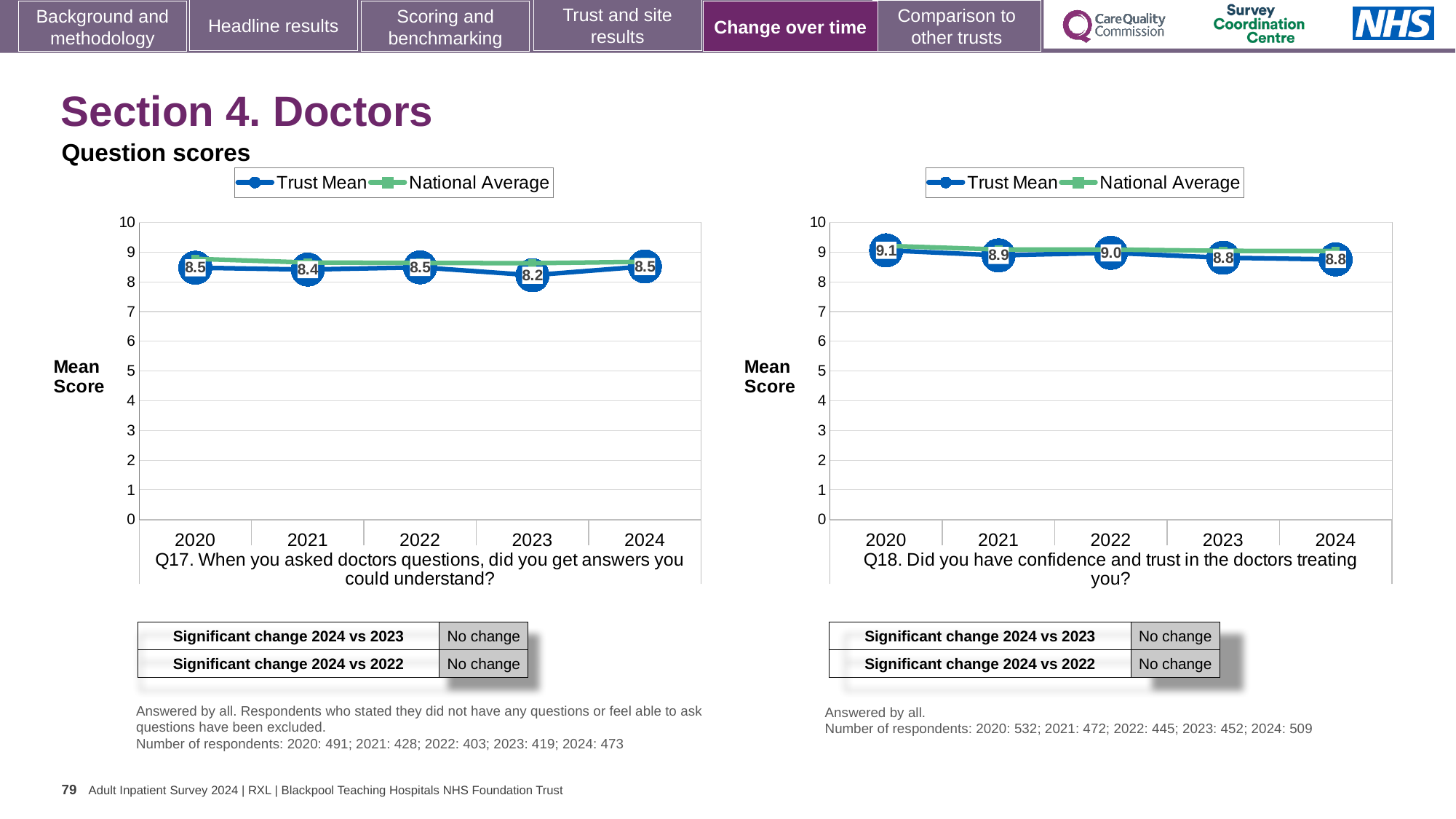
In the Q17 chart, is the National Average value for 2020 greater or less than 8? greater How many years are shown on the x axis of the Q18 chart? 5 In the Q18 chart, what is the difference between the Trust Mean scores for 2020 and 2024? 0.3 In the Q18 chart, does the Trust Mean score rise or fall from 2020 to 2024? Fall In the Q18 chart, what is the Trust Mean score for 2020? 9.1 In the Q17 chart, which year has the lowest Trust Mean score? 2023 In the Q17 chart, what is the difference between the Trust Mean scores for 2022 and 2023? 0.3 What kind of chart is the Q18 chart? Line chart How many series does the legend of the Q17 chart list? 2 In the Q18 chart, which year has the highest Trust Mean score? 2020 In the Q17 chart, what is the Trust Mean score for 2023? 8.2 In the Q18 chart, which year has the larger Trust Mean score, 2021 or 2022? 2022